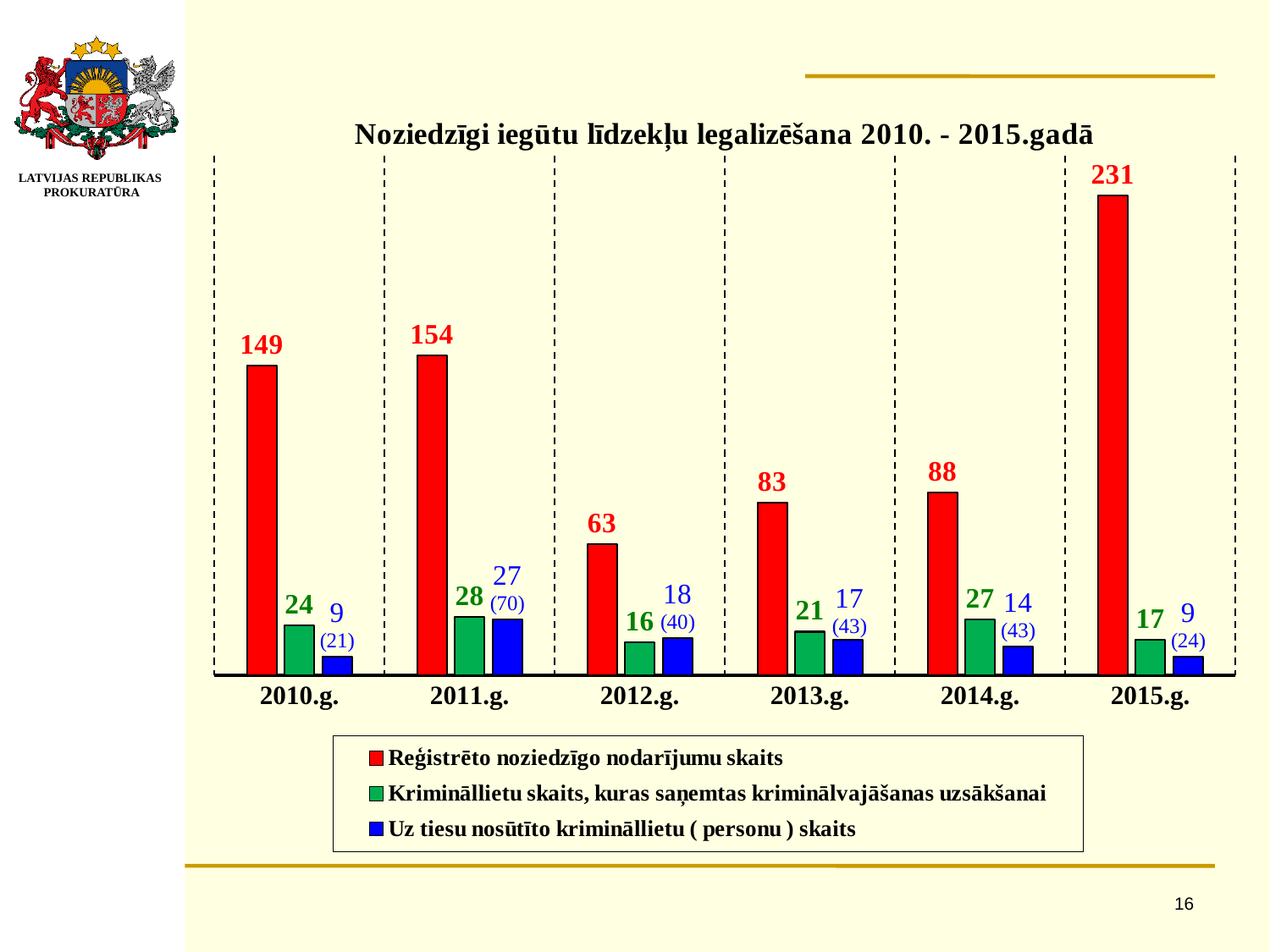
What is the value of Uz tiesu nosūtīto krimināllietu (personu) skaits for 2012.g.? 18 What is the difference between the Reģistrēto noziedzīgo nodarījumu skaits values for 2015.g. and 2014.g.? 143 How many years are shown on the x axis? 6 What number is shown in parentheses under the blue bar for 2011.g.? (70) Which year has the lowest value for Reģistrēto noziedzīgo nodarījumu skaits? 2012.g. How many series does the legend list? 3 What is the value of Krimināllietu skaits, kuras saņemtas kriminālvajāšanas uzsākšanai for 2011.g.? 28 Which year has the highest value for Reģistrēto noziedzīgo nodarījumu skaits? 2015.g. What is the value of Reģistrēto noziedzīgo nodarījumu skaits for 2015.g.? 231 Which is larger: the Krimināllietu skaits value for 2014.g. or for 2015.g.? 2014.g. What kind of chart is shown on the slide? Bar chart What is the title of the chart? Noziedzīgi iegūtu līdzekļu legalizēšana 2010. - 2015.gadā